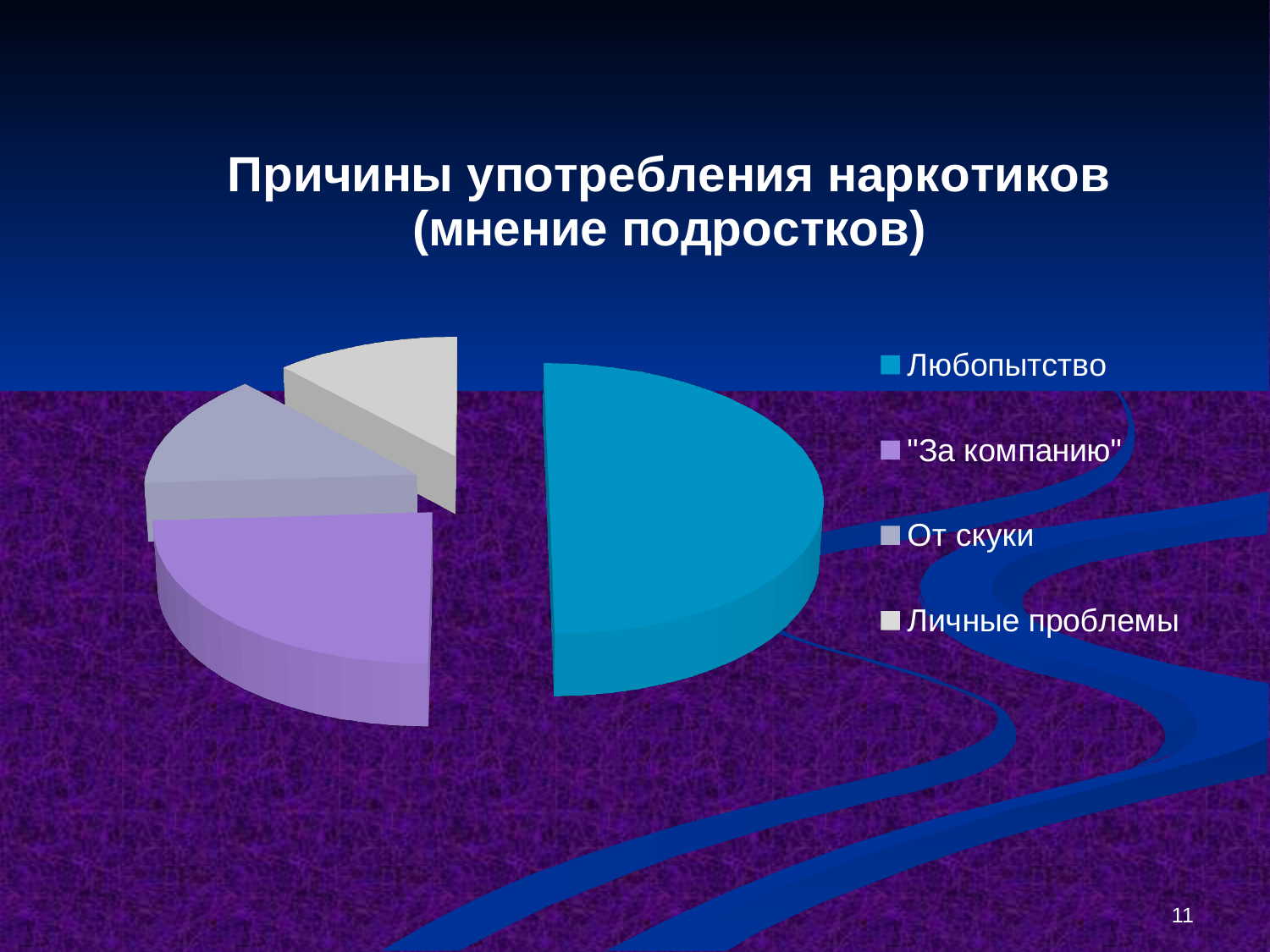
How many entries does the legend list? 4 Which slice is larger: Любопытство or "За компанию"? Любопытство What kind of chart is shown on the slide? Pie chart Which slice is larger: "За компанию" or От скуки? "За компанию" What is the title of the slide containing the chart? Причины употребления наркотиков (мнение подростков) Which category has the largest slice of the pie? Любопытство Which slice is larger: Любопытство or Личные проблемы? Любопытство How many slices does the pie chart have? 4 Which category is shown in the cyan (blue) colour in the pie chart? Любопытство Which category has the smallest slice of the pie? Личные проблемы